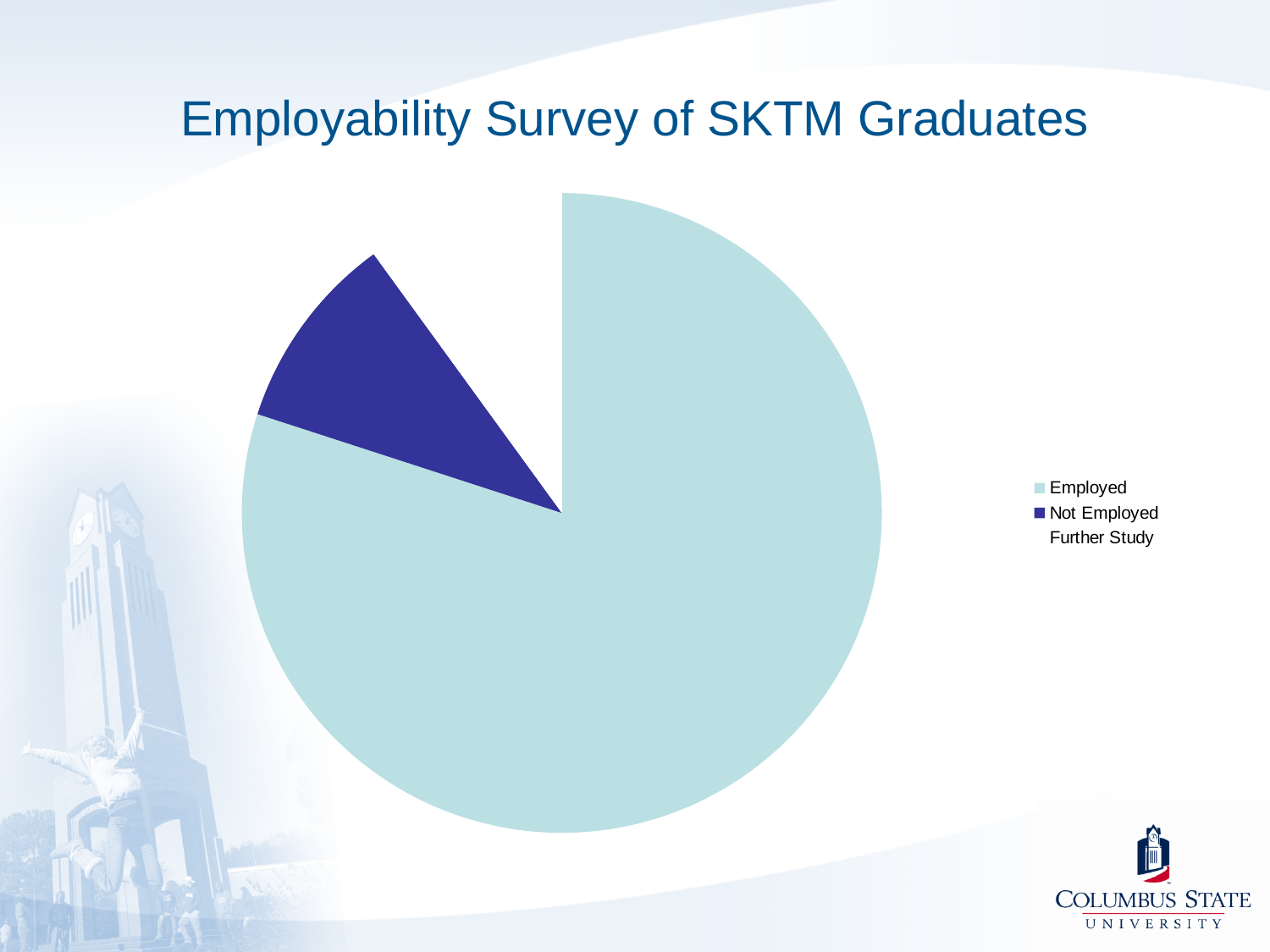
What is the title of the chart on the slide? Employability Survey of SKTM Graduates Which is smaller, the slice for Employed or the slice for Not Employed? Not Employed Which is larger, the slice for Employed or the slice for Not Employed? Employed Which category has the largest slice of the pie? Employed What colour is the slice for Not Employed? dark blue Does the Employed slice take up more or less than half of the pie? more What kind of chart is shown on the slide? pie chart How many categories does the chart legend list? 3